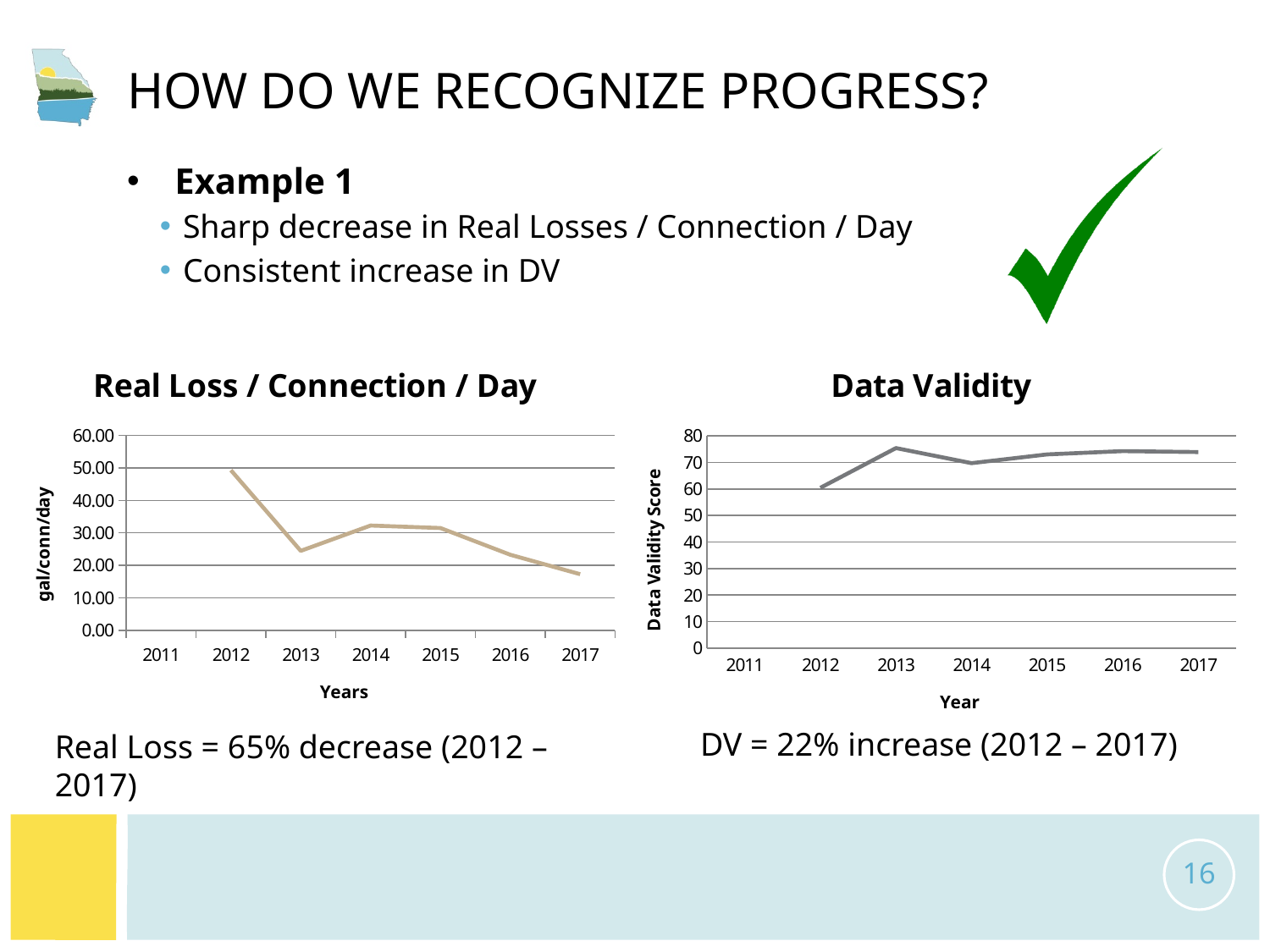
In the Data Validity chart, which year has the lowest value? 2012 How many years are labeled on the x axis of the Data Validity chart? 7 In the Real Loss / Connection / Day chart, which year has the highest value? 2012 What kind of chart is the Real Loss / Connection / Day chart? line chart What is the y-axis label of the Real Loss / Connection / Day chart? gal/conn/day In the Real Loss / Connection / Day chart, is the value for 2012 larger or smaller than the value for 2013? larger In the Data Validity chart, which year has the highest value? 2013 In the Real Loss / Connection / Day chart, is the value for 2012 greater or less than 40.00? greater In the Data Validity chart, is the value for 2012 greater or less than 70? less In the Real Loss / Connection / Day chart, is the value for 2013 greater or less than 30.00? less In the Real Loss / Connection / Day chart, which year has the lowest value? 2017 In the Real Loss / Connection / Day chart, do the values overall rise or fall from 2012 to 2017? fall